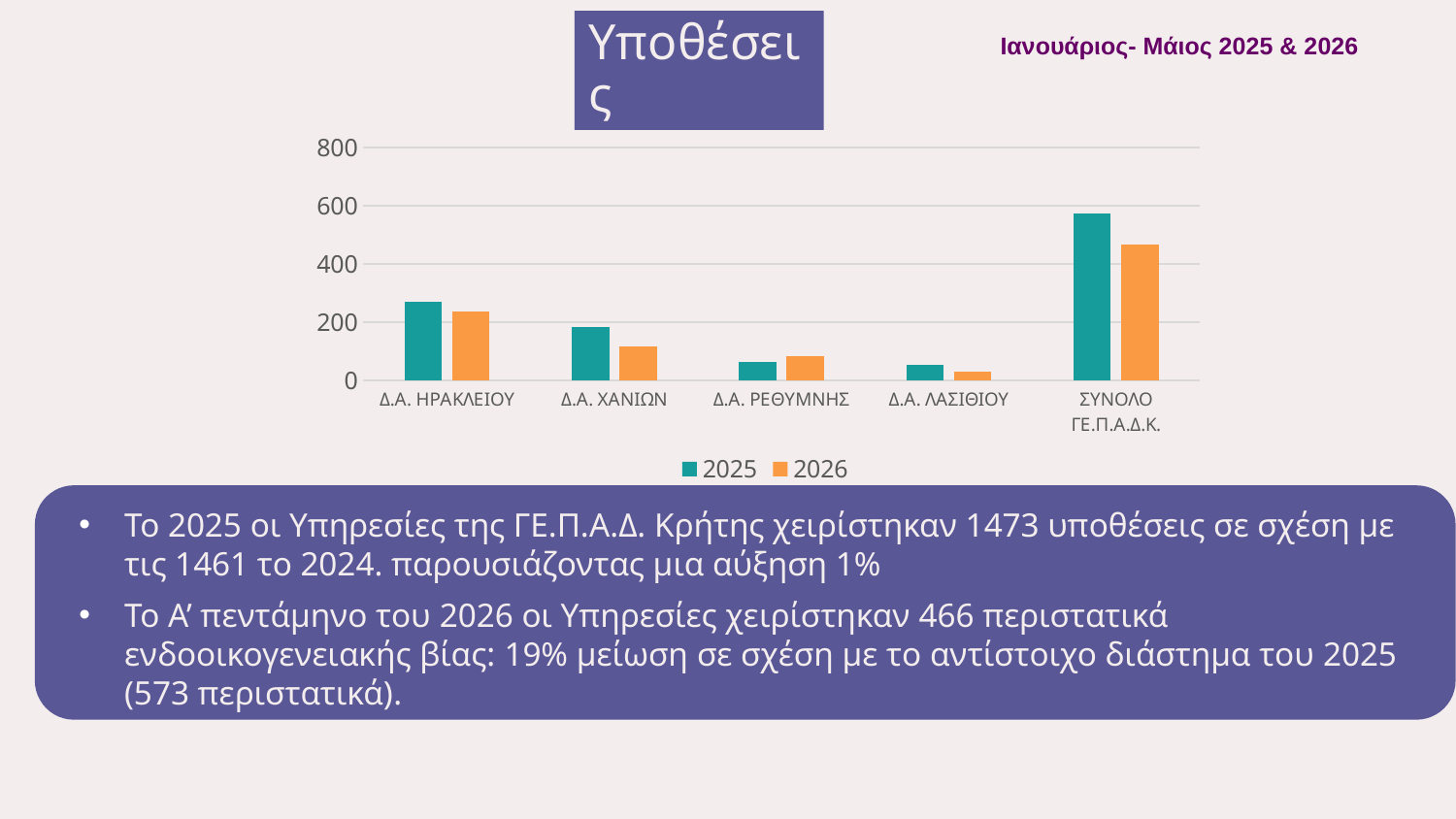
For Δ.Α. ΡΕΘΥΜΝΗΣ, which year has the larger value, 2025 or 2026? 2026 For Δ.Α. ΧΑΝΙΩΝ, which year has the larger value, 2025 or 2026? 2025 Which category has the highest value for 2025? ΣΥΝΟΛΟ ΓΕ.Π.Α.Δ.Κ. Is the 2025 value for ΣΥΝΟΛΟ ΓΕ.Π.Α.Δ.Κ. greater or less than 400? greater How many series does the legend list? 2 What is the title of the chart? Υποθέσεις Which colour represents the 2026 series in the legend? orange How many categories are shown on the x axis? 5 What kind of chart is shown on the slide? bar chart Is the 2025 value for Δ.Α. ΗΡΑΚΛΕΙΟΥ greater or less than 200? greater Which category has the lowest value for 2026? Δ.Α. ΛΑΣΙΘΙΟΥ Is the 2026 value for Δ.Α. ΧΑΝΙΩΝ greater or less than 200? less